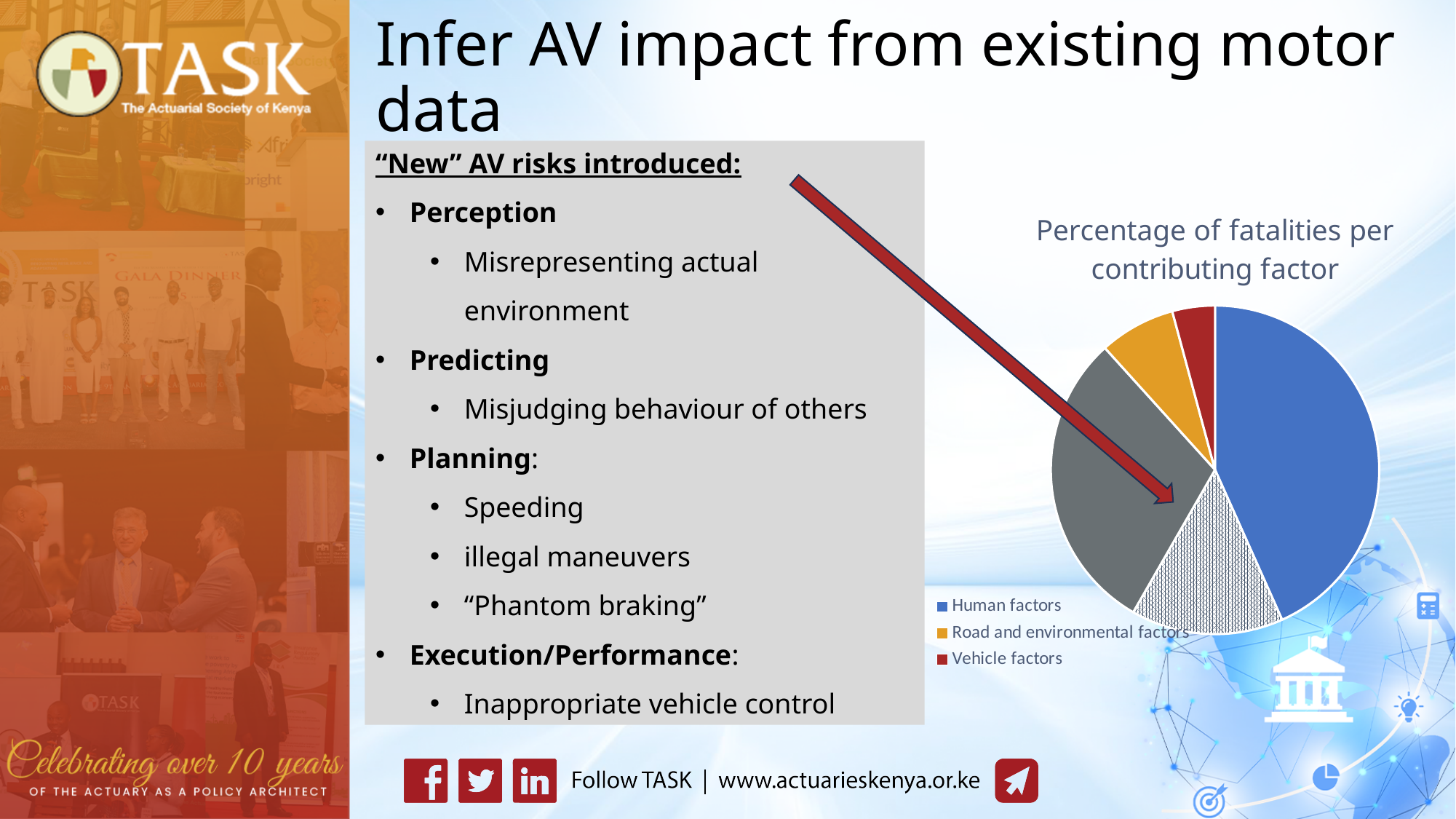
Is the Human factors slice greater or less than half of the pie? less What is the title of the pie chart? Percentage of fatalities per contributing factor Which contributing factor has the largest slice in the pie chart? Human factors Which slice is larger in the pie chart, Human factors or Vehicle factors? Human factors How many entries does the legend of the pie chart list? 3 Which slice is larger in the pie chart, Road and environmental factors or Vehicle factors? Road and environmental factors Which slice is larger in the pie chart, Human factors or Road and environmental factors? Human factors What kind of chart is shown on the slide? pie chart Which contributing factor has the smallest slice in the pie chart? Vehicle factors What colour represents Human factors in the pie chart? blue